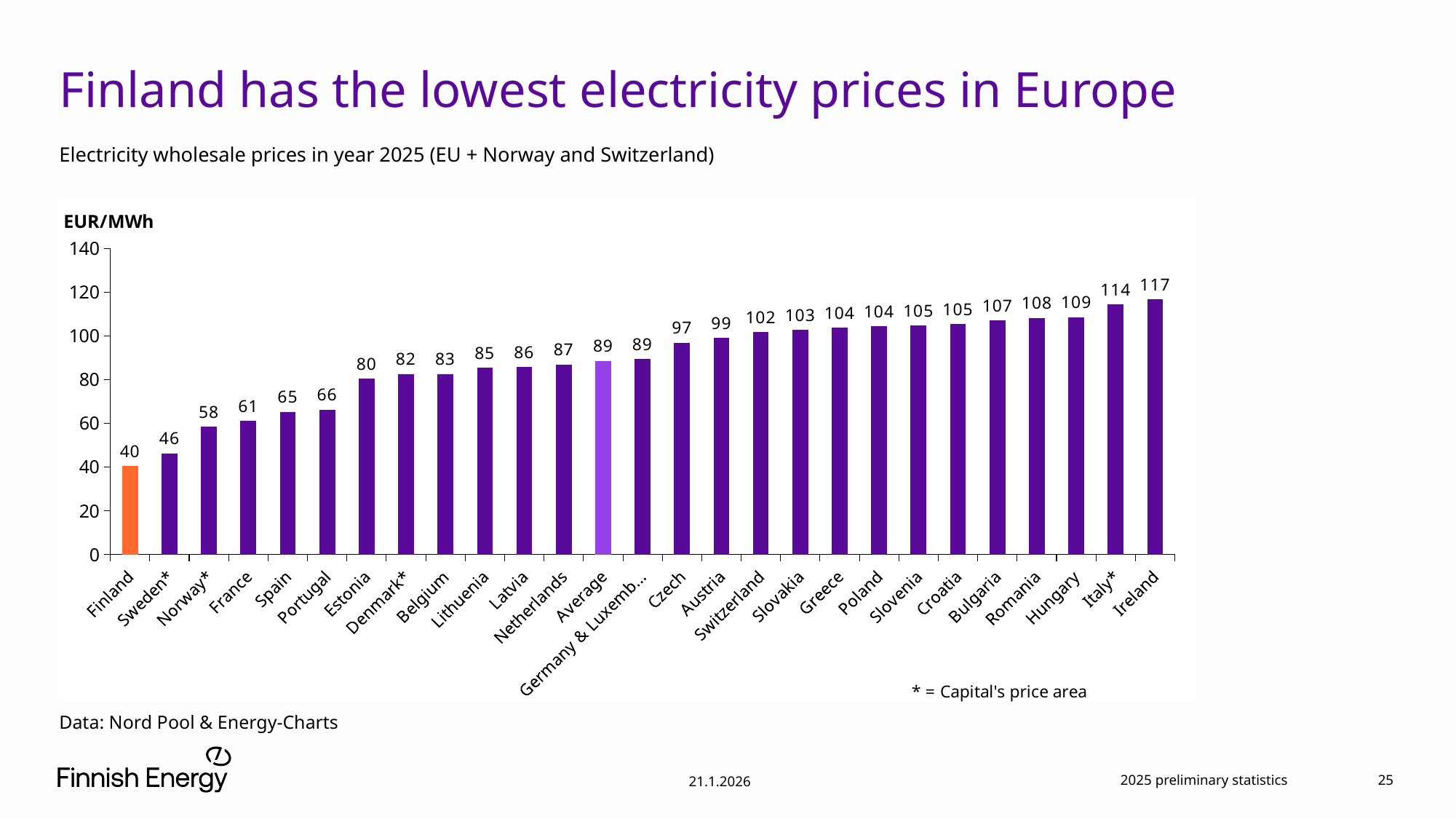
What is the electricity wholesale price for Finland in EUR/MWh? 40 How many bars are shown on the chart? 27 What is the value shown for Ireland? 117 Which has a higher value, France or Spain? Spain What is the difference between the values for Ireland and Finland? 77 Which country has the highest electricity wholesale price on the chart? Ireland What unit is shown on the y axis of the chart? EUR/MWh Which country has the lowest electricity wholesale price on the chart? Finland What is the difference between the values for Sweden* and Finland? 6 What is the value shown for Estonia? 80 What type of chart is shown on the slide? Bar chart What is the value shown for the Average bar? 89